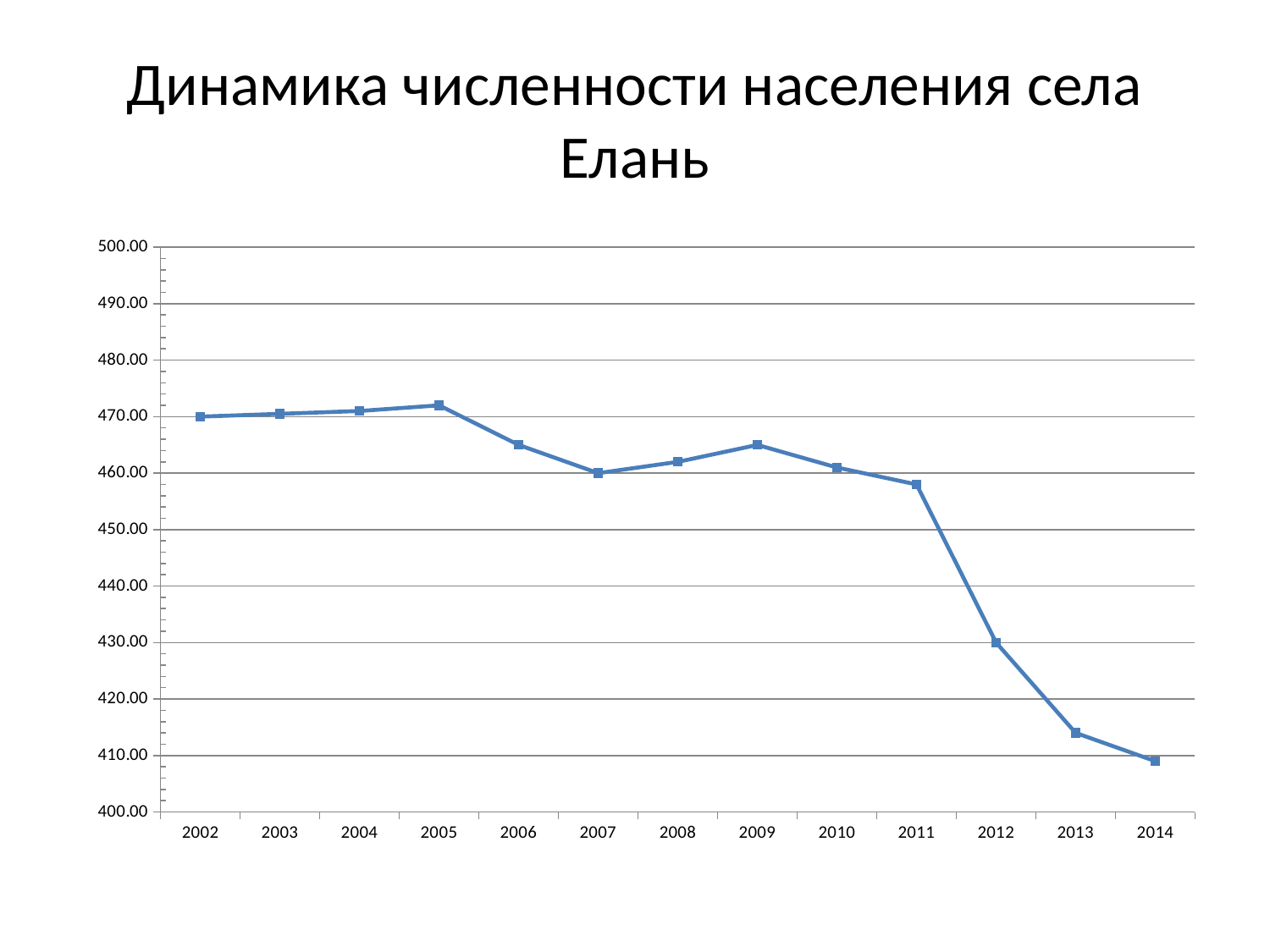
Overall, do the values rise or fall from 2002 to 2014? fall What is the title of the slide? Динамика численности населения села Елань How many years are plotted along the x axis? 13 Which year has the larger value, 2006 or 2010? 2006 What kind of chart is shown on the slide? line chart Is the value for 2013 greater or less than 420.00? less What is the value for 2007? 460.00 In which year is the population value highest? 2005 In which year is the population value lowest? 2014 Is the value for 2009 greater or less than 460.00? greater Is the value for 2011 greater or less than 460.00? less